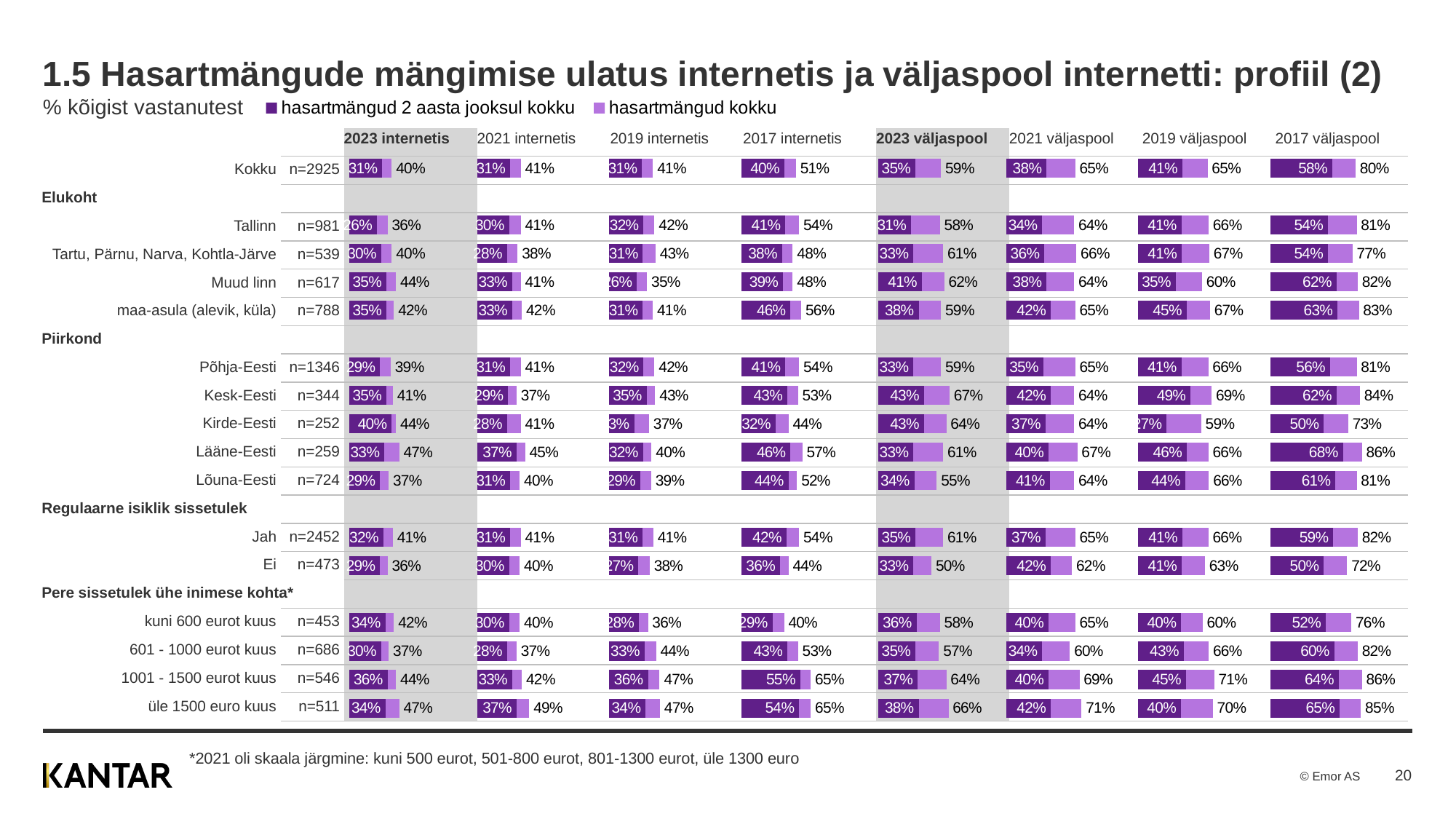
In the 2017 väljaspool column, what is the hasartmängud 2 aasta jooksul kokku value for Tallinn? 54% Among the Piirkond rows, which region has the highest hasartmängud kokku value in the 2017 väljaspool column? Lääne-Eesti In the 2023 internetis column, what is the hasartmängud kokku value for the Kokku row? 40% Looking at the väljaspool columns from 2017 to 2023, does the Kokku hasartmängud kokku value rise or fall? Fall What is the sample size (n) shown for the Kokku row? n=2925 Among the Elukoht rows, which has the lowest hasartmängud 2 aasta jooksul kokku value in the 2023 internetis column? Tallinn How many series does the legend list? 2 In the 2017 väljaspool column, what is the hasartmängud kokku value for Lääne-Eesti? 86% What kind of chart is used to show the values on this slide? Bar chart For the Kokku row in the 2017 väljaspool column, what is the difference between hasartmängud kokku (80%) and hasartmängud 2 aasta jooksul kokku (58%)? 22 percentage points In the 2023 väljaspool column, which has the larger hasartmängud kokku value: Kesk-Eesti or Kirde-Eesti? Kesk-Eesti How many year/channel columns (e.g. 2023 internetis, 2021 väljaspool) are shown in the chart? 8